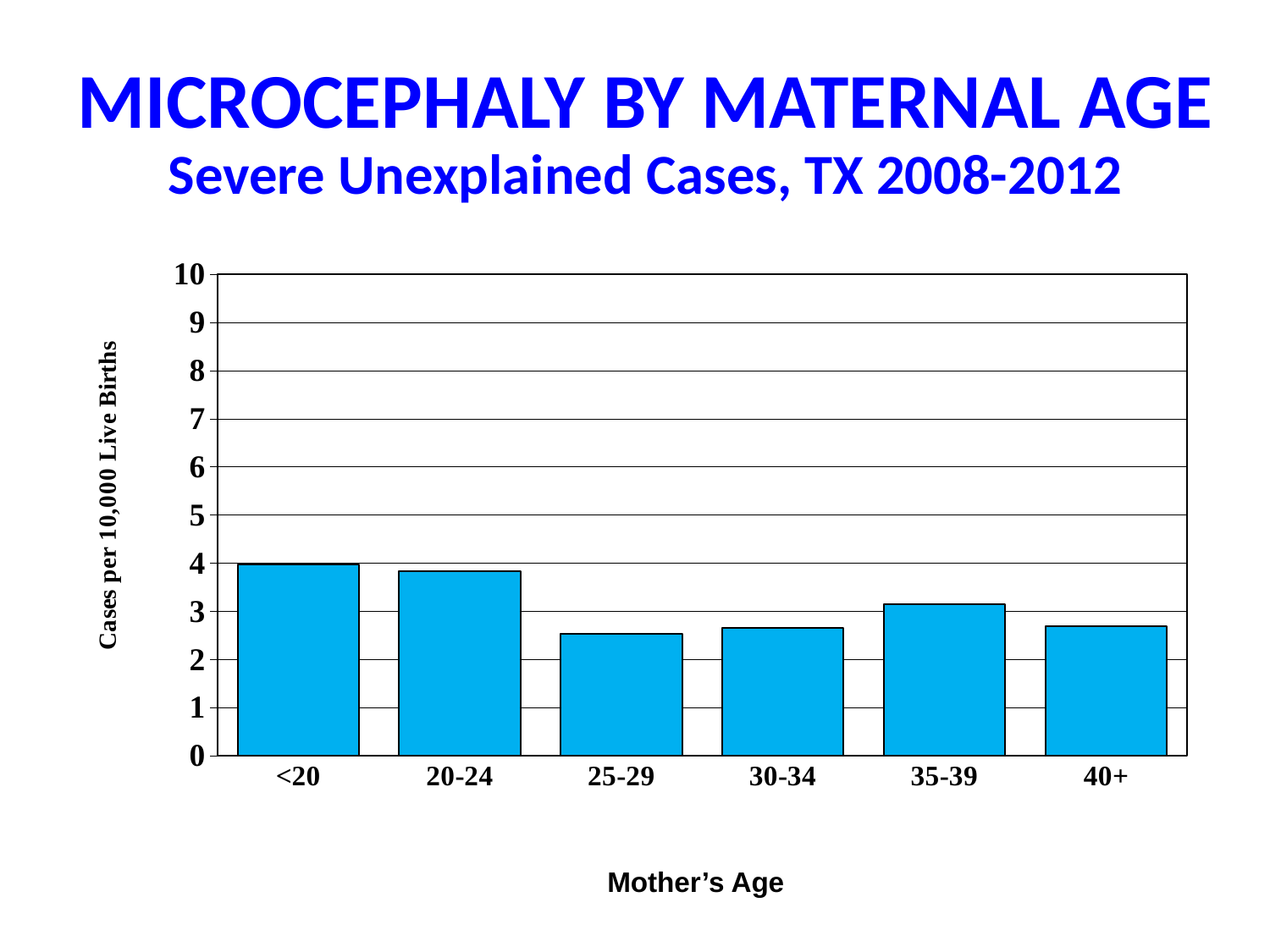
Is the value for the 35-39 age group greater or less than 3? greater Which has the higher value, the 35-39 age group or the 40+ age group? 35-39 Is the value for the 20-24 age group greater or less than 4? less What is the label of the x axis? Mother's Age Is the value for the 30-34 age group greater or less than 3? less Which has the higher value, the 20-24 age group or the 25-29 age group? 20-24 What is the label of the y axis? Cases per 10,000 Live Births Do the values rise or fall from the <20 group to the 25-29 group? fall What kind of chart is shown on the slide? bar chart How many maternal age categories are shown on the x axis? 6